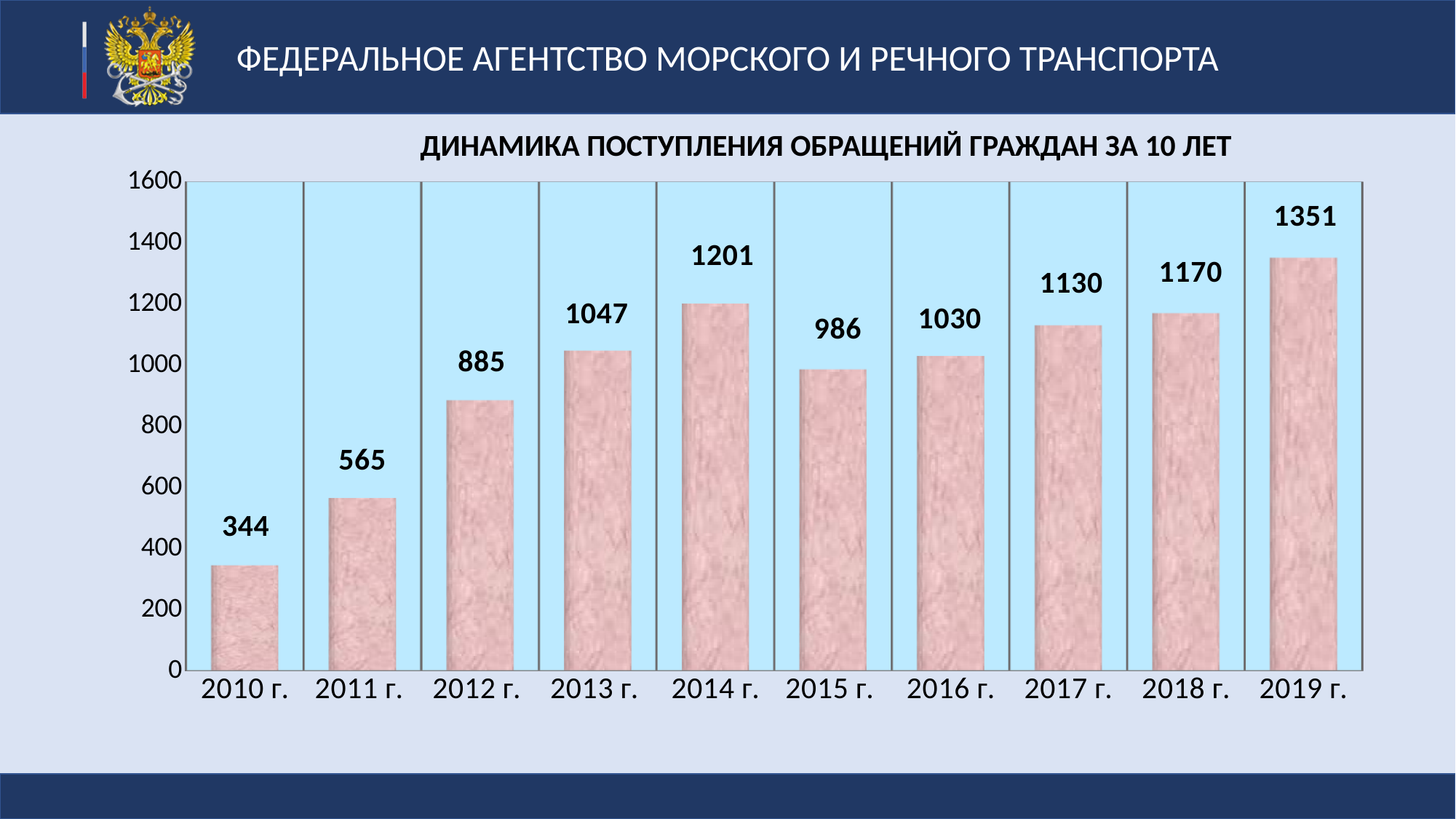
What is the difference between the values for 2014 г. and 2015 г.? 215 What is the value for 2010 г.? 344 Which year has the lowest value? 2010 г. Is the value for 2012 г. greater or less than 1000? less What is the value for 2017 г.? 1130 What is the difference between the values for 2019 г. and 2018 г.? 181 How many years are shown on the x axis? 10 What is the title of the chart? ДИНАМИКА ПОСТУПЛЕНИЯ ОБРАЩЕНИЙ ГРАЖДАН ЗА 10 ЛЕТ Which is larger, the value for 2013 г. or the value for 2016 г.? 2013 г. Which year has the highest value? 2019 г. What is the value for 2014 г.? 1201 What kind of chart is shown on the slide? bar chart